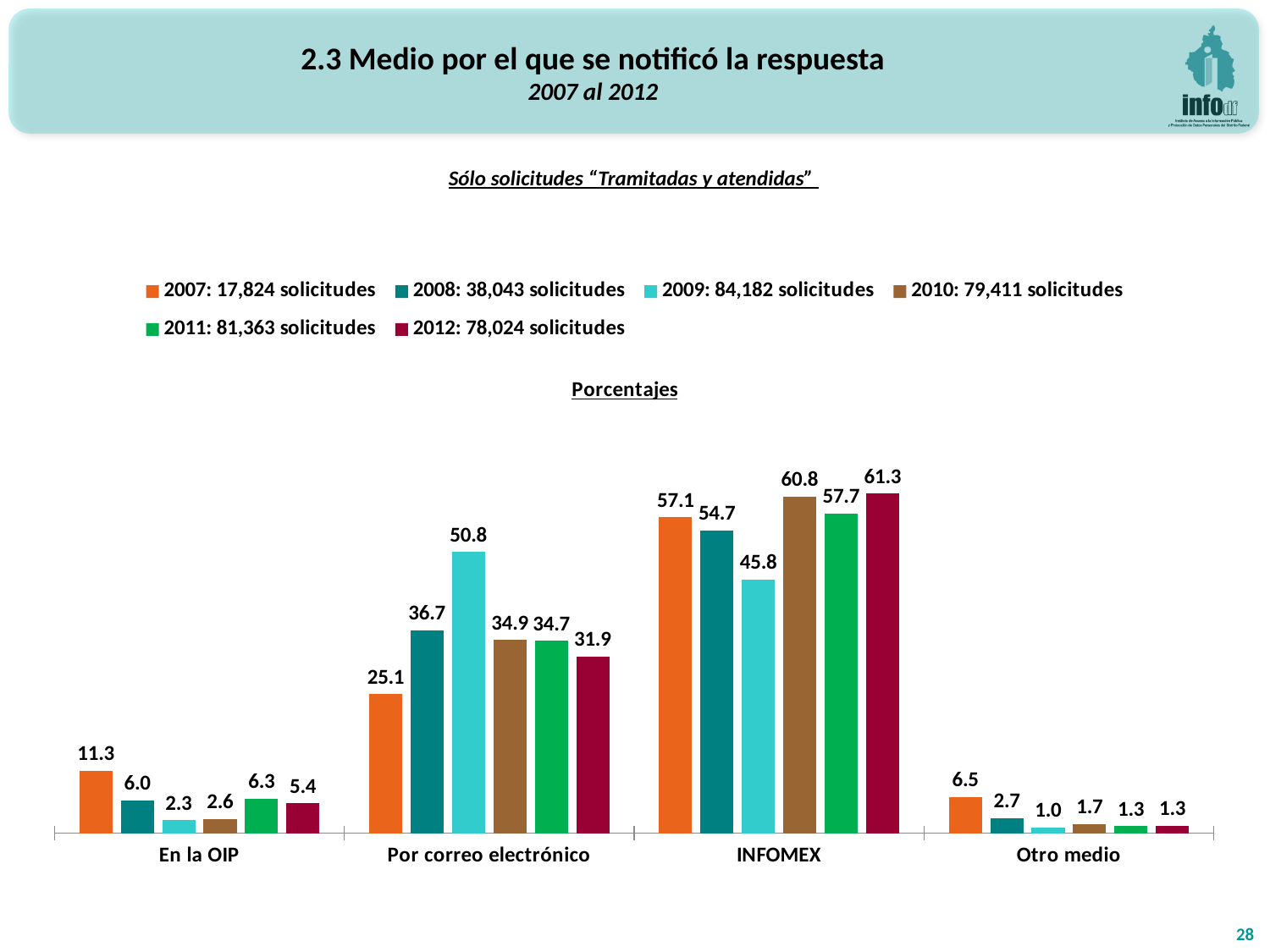
How do the values for 'Por correo electrónico' change from 2009 to 2012? They fall What is the value for 2007 in the 'En la OIP' category? 11.3 What is the value for 2009 in the 'Por correo electrónico' category? 50.8 Which is larger in the 'En la OIP' category: the value for 2008 or the value for 2011? 2011 What is the value for 2012 in the INFOMEX category? 61.3 How many categories are shown on the x axis? 4 What is the difference between the 2009 and 2007 values in the 'Por correo electrónico' category? 25.7 Which year has the highest value in the INFOMEX category? 2012 According to the legend, how many solicitudes were there in 2009? 84,182 How many series does the legend list? 6 What type of chart is shown on the slide? bar chart Which year has the lowest value in the 'Otro medio' category? 2009